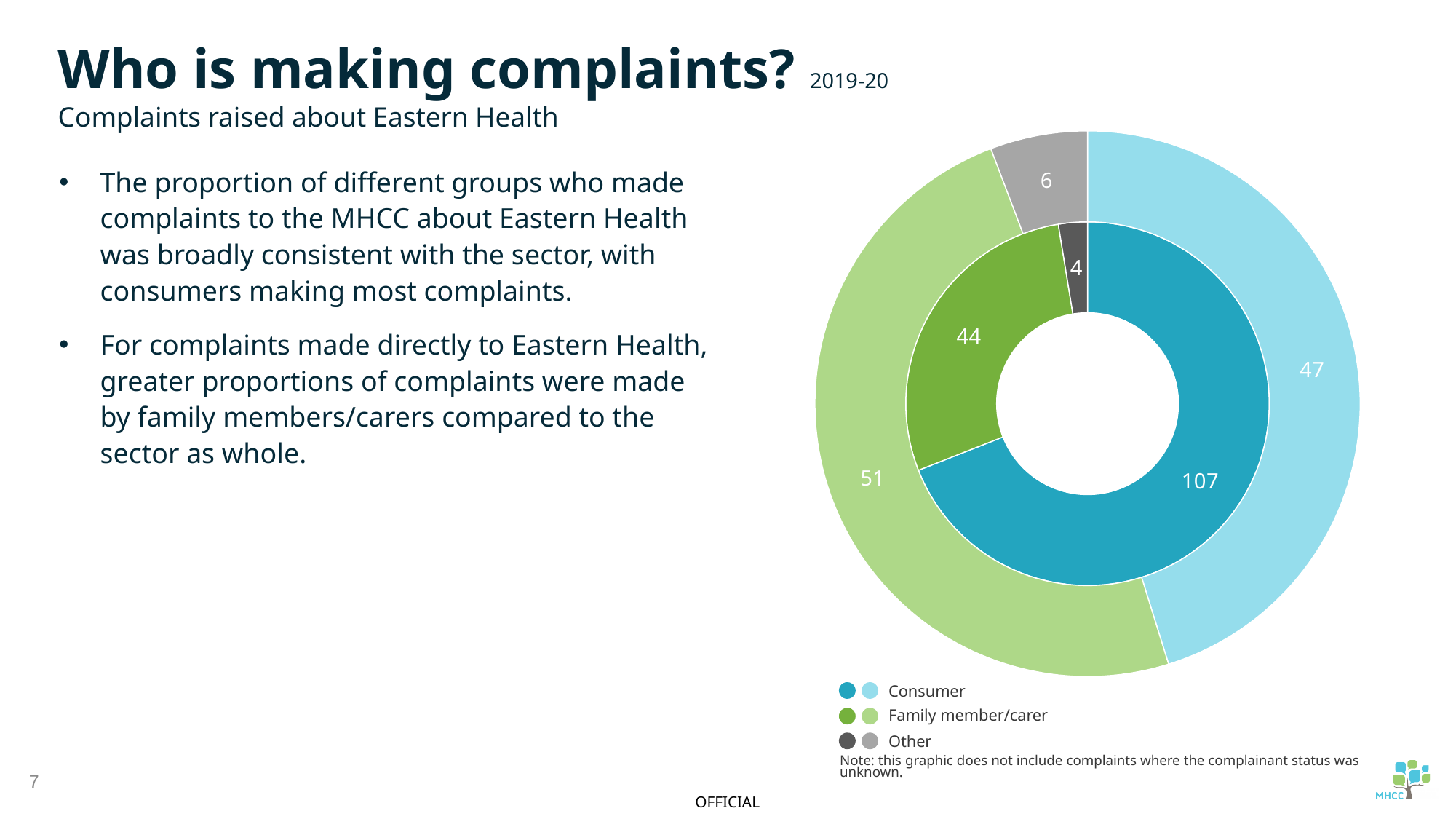
How many categories does the chart legend list? 3 Which category has the smallest value in the outer ring of the doughnut chart? Other In the inner ring of the doughnut chart, what is the value for Consumer? 107 In the outer ring of the doughnut chart, what is the value for Consumer? 47 In the inner ring, what is the difference between the Consumer value and the Family member/carer value? 63 In the outer ring of the doughnut chart, what is the value for Other? 6 In the inner ring of the doughnut chart, what is the value for Family member/carer? 44 In the outer ring of the doughnut chart, what is the value for Family member/carer? 51 Which category has the largest value in the inner ring of the doughnut chart? Consumer In the inner ring of the doughnut chart, what is the value for Other? 4 In the outer ring, which is larger: Consumer or Family member/carer? Family member/carer What kind of chart is shown on the slide? Doughnut chart